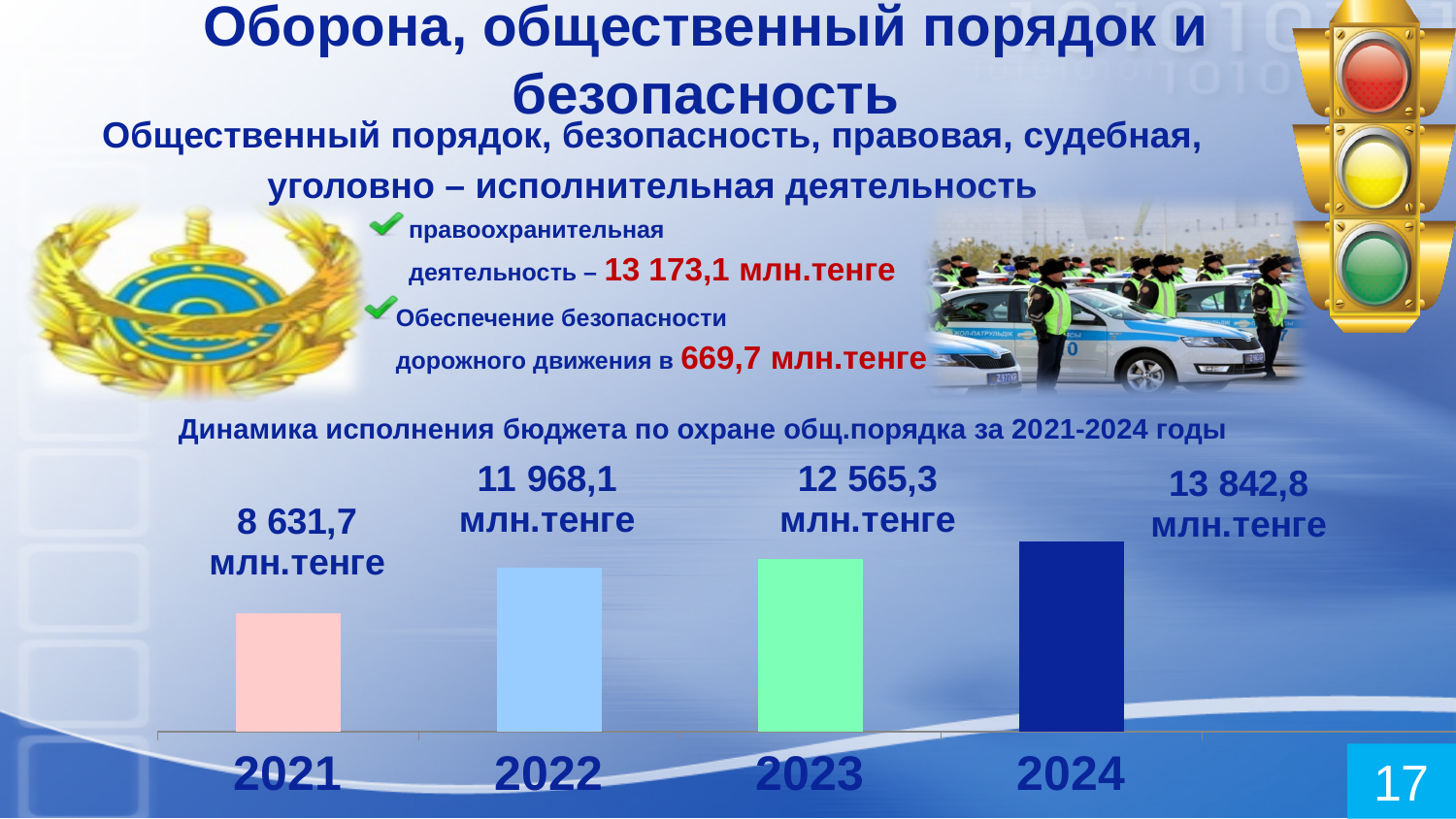
How many years (bars) are shown in the chart? 4 What is the difference between the 2024 and 2021 values in the chart? 5 211,1 млн.тенге Which is larger in the chart, the value for 2022 or the value for 2023? 2023 What is the difference between the 2023 and 2022 values in the chart? 597,2 млн.тенге What value is shown for 2023 in the chart? 12 565,3 млн.тенге Which year has the highest value in the chart? 2024 What value is shown for 2024 in the chart? 13 842,8 млн.тенге What kind of chart is shown on the slide? Bar chart What is the title of the chart on the slide? Динамика исполнения бюджета по охране общ.порядка за 2021-2024 годы Do the values in the chart rise or fall from 2021 to 2024? Rise What value is shown for 2021 in the chart? 8 631,7 млн.тенге Which year has the lowest value in the chart? 2021